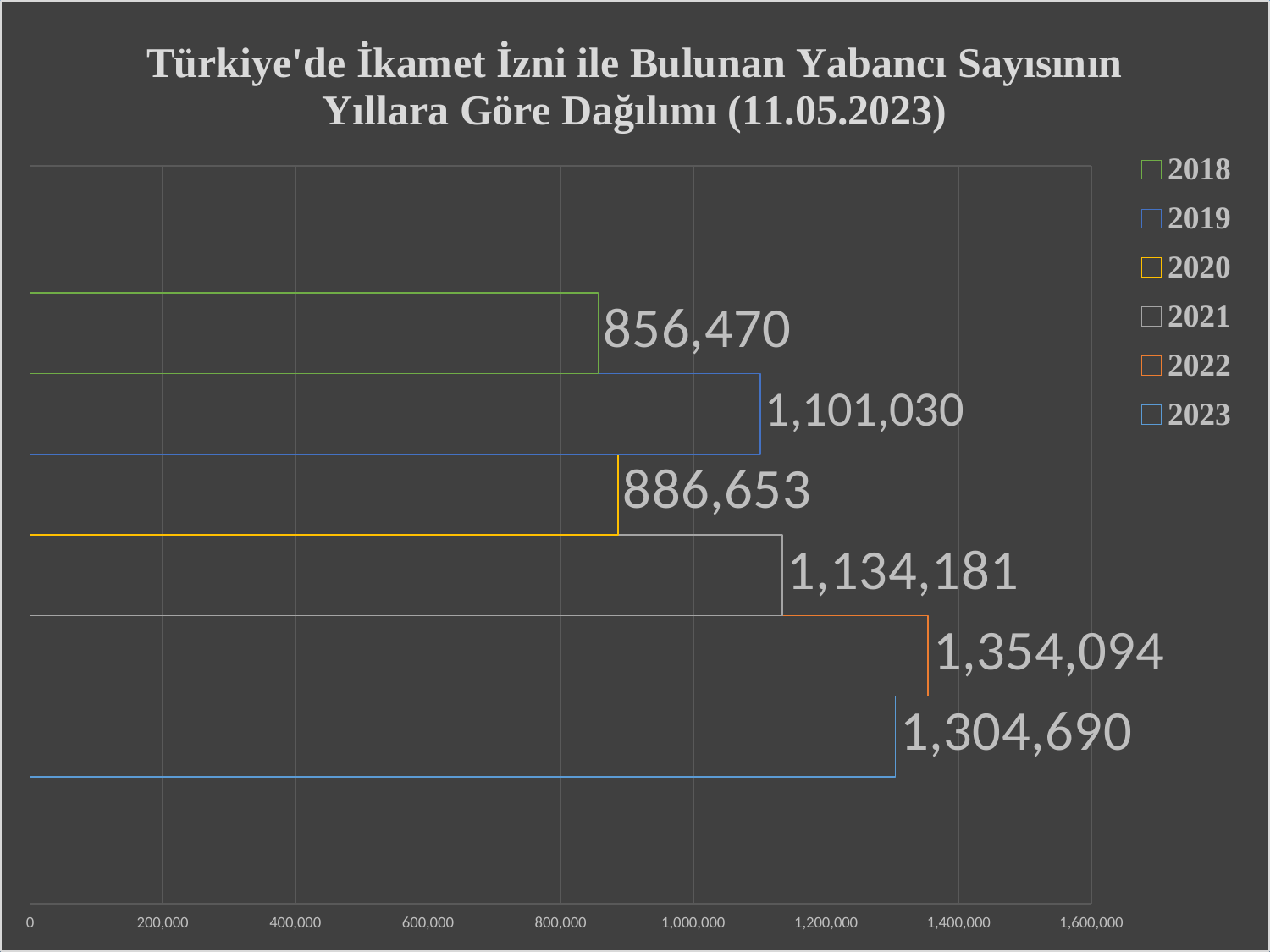
What is the difference between the values for 2022 and 2023? 49,404 What is the value for 2022? 1,354,094 Is the value for 2020 greater or less than 1,000,000? less Which year has the highest value? 2022 Which is larger, the value for 2021 or the value for 2019? 2021 What is the difference between the values for 2019 and 2018? 244,560 How many series does the legend list? 6 What kind of chart is shown on the slide? Bar chart What is the value for 2020? 886,653 What is the value for 2023? 1,304,690 Which year has the lowest value? 2018 What is the value for 2018? 856,470